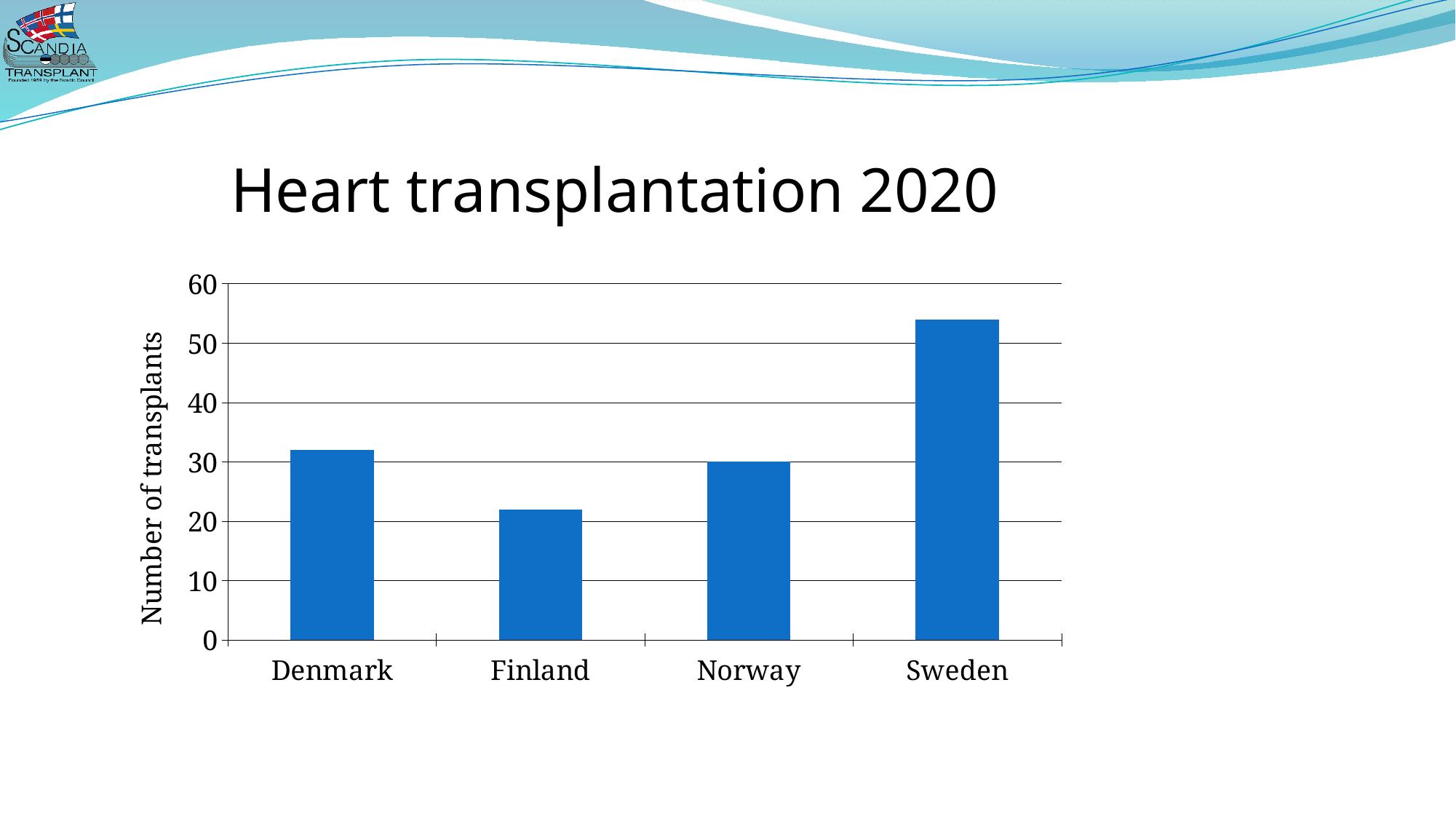
Is the value for Sweden greater or less than 50? greater Which has more heart transplants, Denmark or Finland? Denmark Is the value for Finland greater or less than 30? less What is the label on the y axis of the chart? Number of transplants What is the number of transplants for Norway? 30 What is the title of the slide containing the chart? Heart transplantation 2020 Which country has the lowest number of heart transplants in the chart? Finland Is the value for Denmark greater or less than 30? greater How many countries are shown on the x axis of the chart? 4 Which country has the highest number of heart transplants in the chart? Sweden What kind of chart is shown on the slide? bar chart